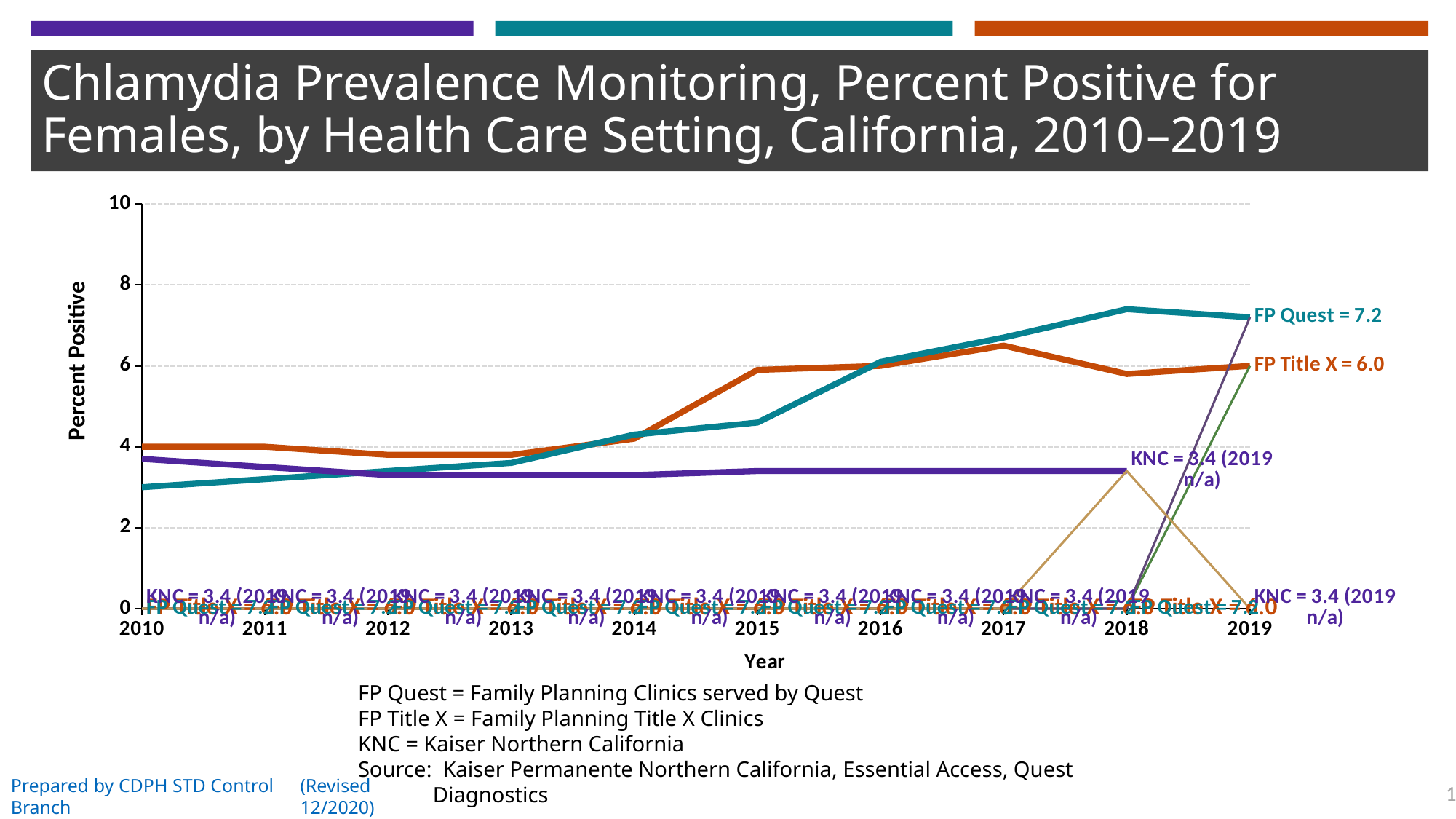
What is the percent positive for FP Title X in 2019? 6.0 How many years are shown on the x axis? 10 How many series are plotted on the chart? 3 What is the percent positive for KNC in 2018? 3.4 Which is larger in 2019, FP Quest or FP Title X? FP Quest Does the FP Quest line rise or fall from 2010 to 2019? rise Is the value for FP Quest in 2010 greater or less than 4? less Is the value for FP Title X in 2015 greater or less than 4? greater What kind of chart is shown on the slide? line chart Which series has the highest value in 2019? FP Quest What is the percent positive for FP Quest in 2019? 7.2 What is the difference between the FP Quest and FP Title X values in 2019? 1.2